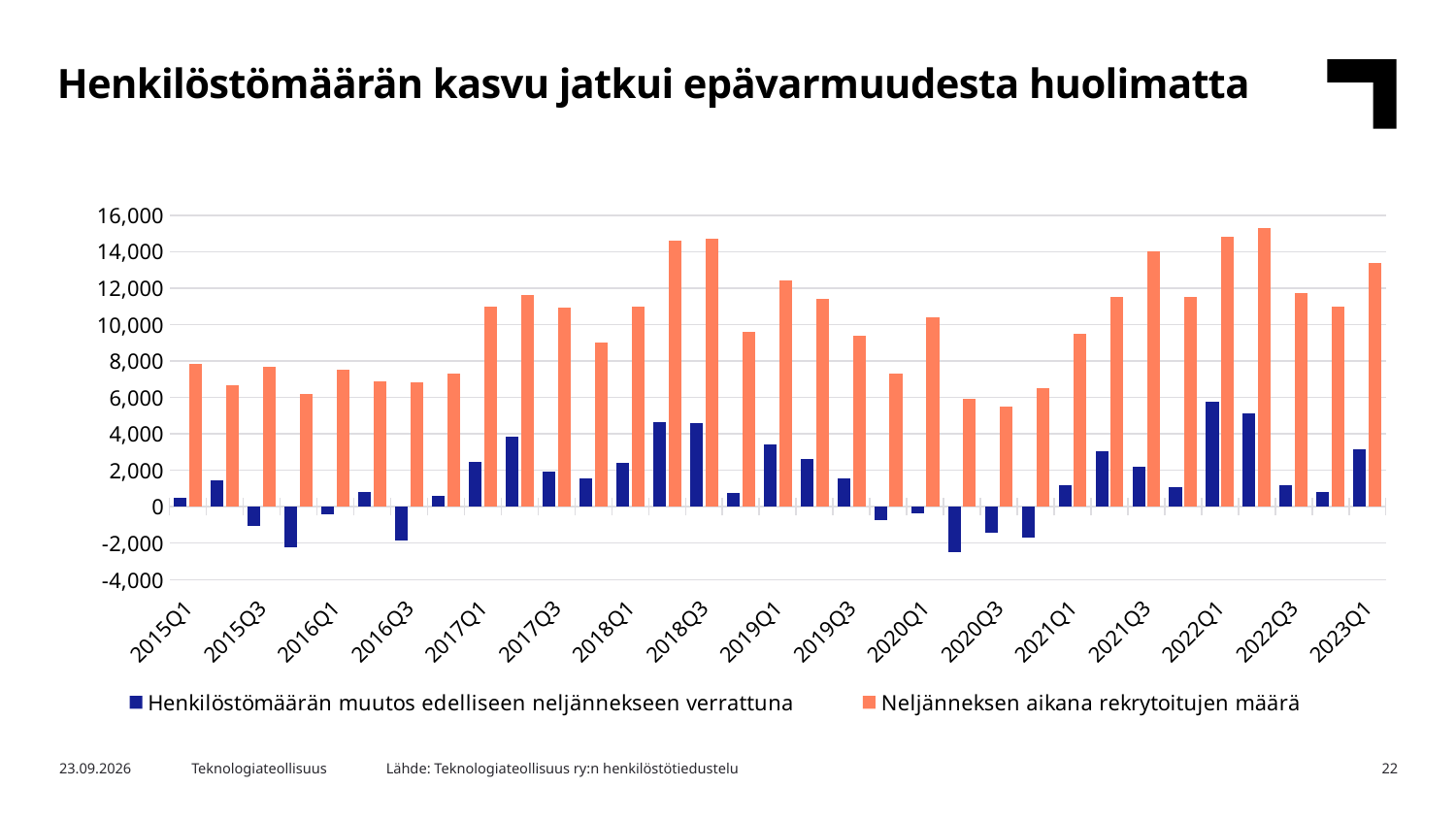
Which is larger for Henkilöstömäärän muutos edelliseen neljännekseen verrattuna: 2017Q3 or 2018Q3? 2018Q3 Is the value of Henkilöstömäärän muutos edelliseen neljännekseen verrattuna for 2022Q1 greater or less than 4,000? greater How many quarter labels are shown on the x axis? 17 Which series is shown in orange according to the legend? Neljänneksen aikana rekrytoitujen määrä What is the title of the slide? Henkilöstömäärän kasvu jatkui epävarmuudesta huolimatta Is the value of Henkilöstömäärän muutos edelliseen neljännekseen verrattuna for 2020Q3 greater or less than 0? less Is the value of Neljänneksen aikana rekrytoitujen määrä for 2022Q1 greater or less than 14,000? greater How many series does the legend list? 2 What kind of chart is shown on the slide? bar chart Which is larger for Neljänneksen aikana rekrytoitujen määrä: 2015Q1 or 2022Q1? 2022Q1